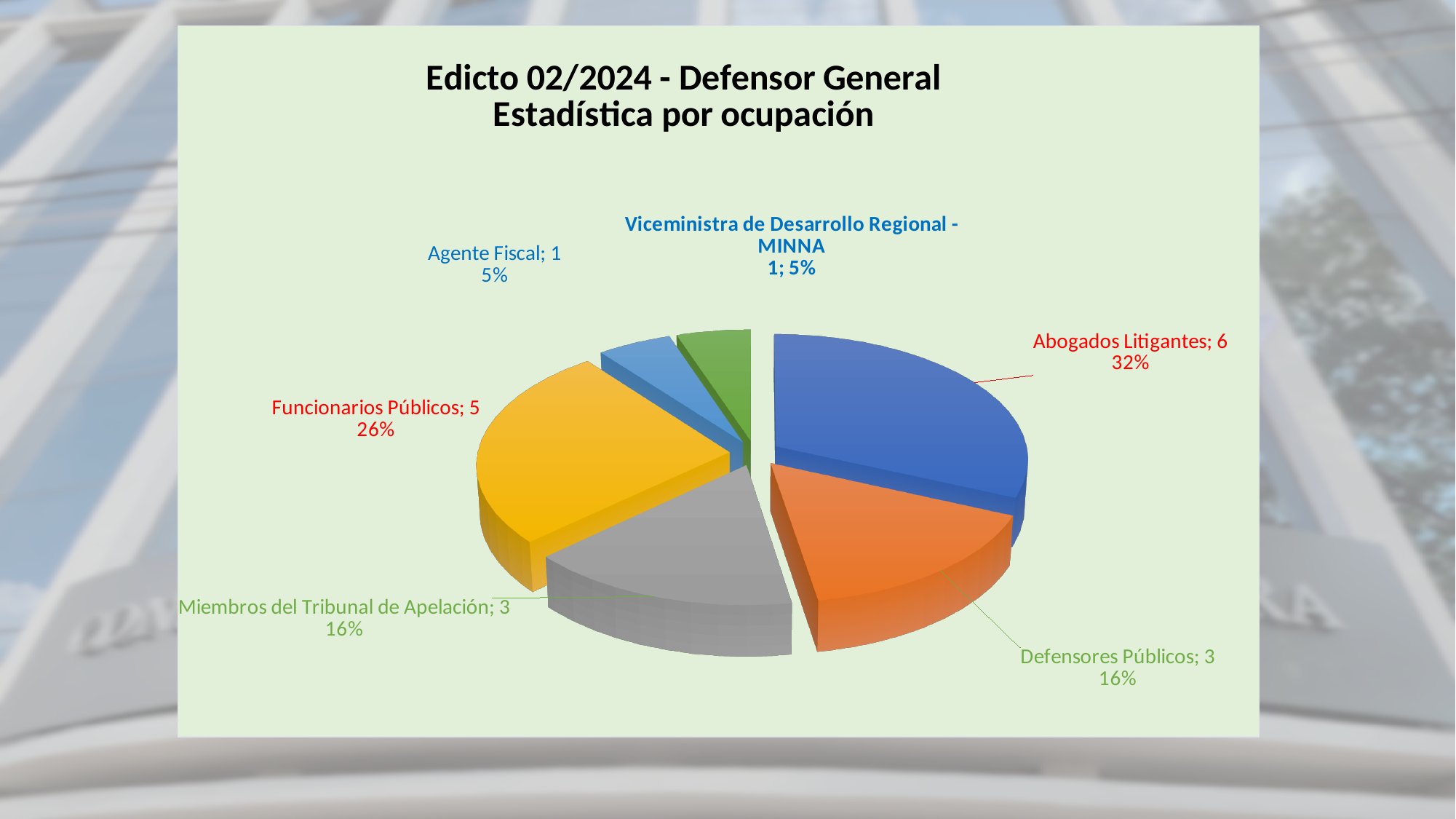
What is the value for Abogados Litigantes? 6 What share of the pie does Abogados Litigantes represent? 32% What share of the pie does Funcionarios Públicos represent? 26% Which category has the largest slice? Abogados Litigantes What is the title of the chart? Edicto 02/2024 - Defensor General Estadística por ocupación How many slices does the pie chart have? 6 Which is larger, the value for Funcionarios Públicos or the value for Defensores Públicos? Funcionarios Públicos What is the value for Miembros del Tribunal de Apelación? 3 What share of the pie does Agente Fiscal represent? 5% What is the value for Funcionarios Públicos? 5 What is the difference between the values for Abogados Litigantes and Funcionarios Públicos? 1 What kind of chart is shown on the slide? Pie chart